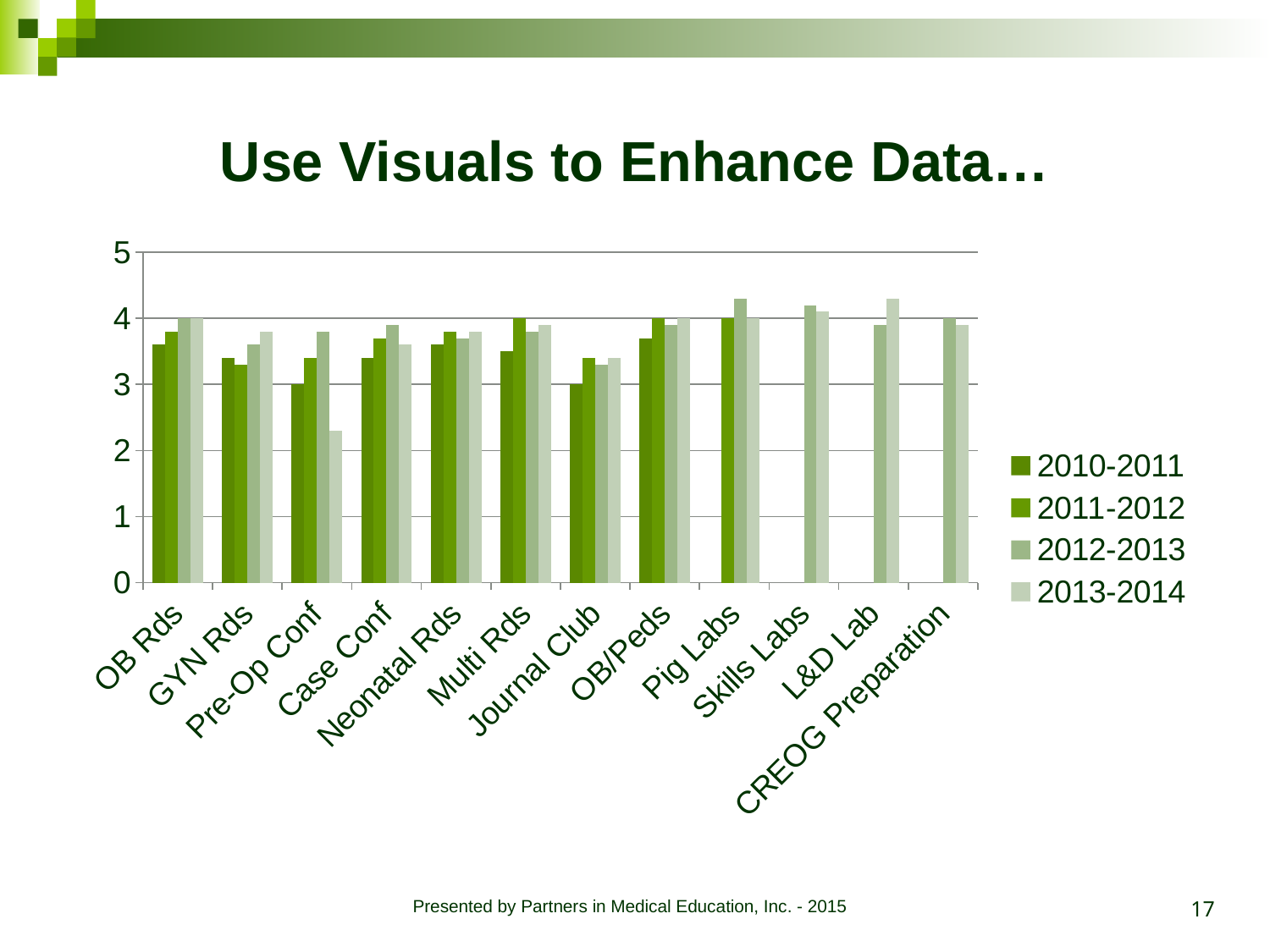
Is the 2012-2013 value for Skills Labs greater or less than 4? greater For Pre-Op Conf, which is larger: the 2012-2013 value or the 2013-2014 value? 2012-2013 Which category has the lowest 2013-2014 value? Pre-Op Conf Is the 2012-2013 value for Pig Labs greater or less than 4? greater Is the 2013-2014 value for Pre-Op Conf greater or less than 3? less Which series is listed first in the chart's legend? 2010-2011 What is the title of the slide containing the chart? Use Visuals to Enhance Data… How many series does the chart's legend list? 4 How many categories are shown along the x axis of the chart? 12 What kind of chart is shown on the slide? bar chart